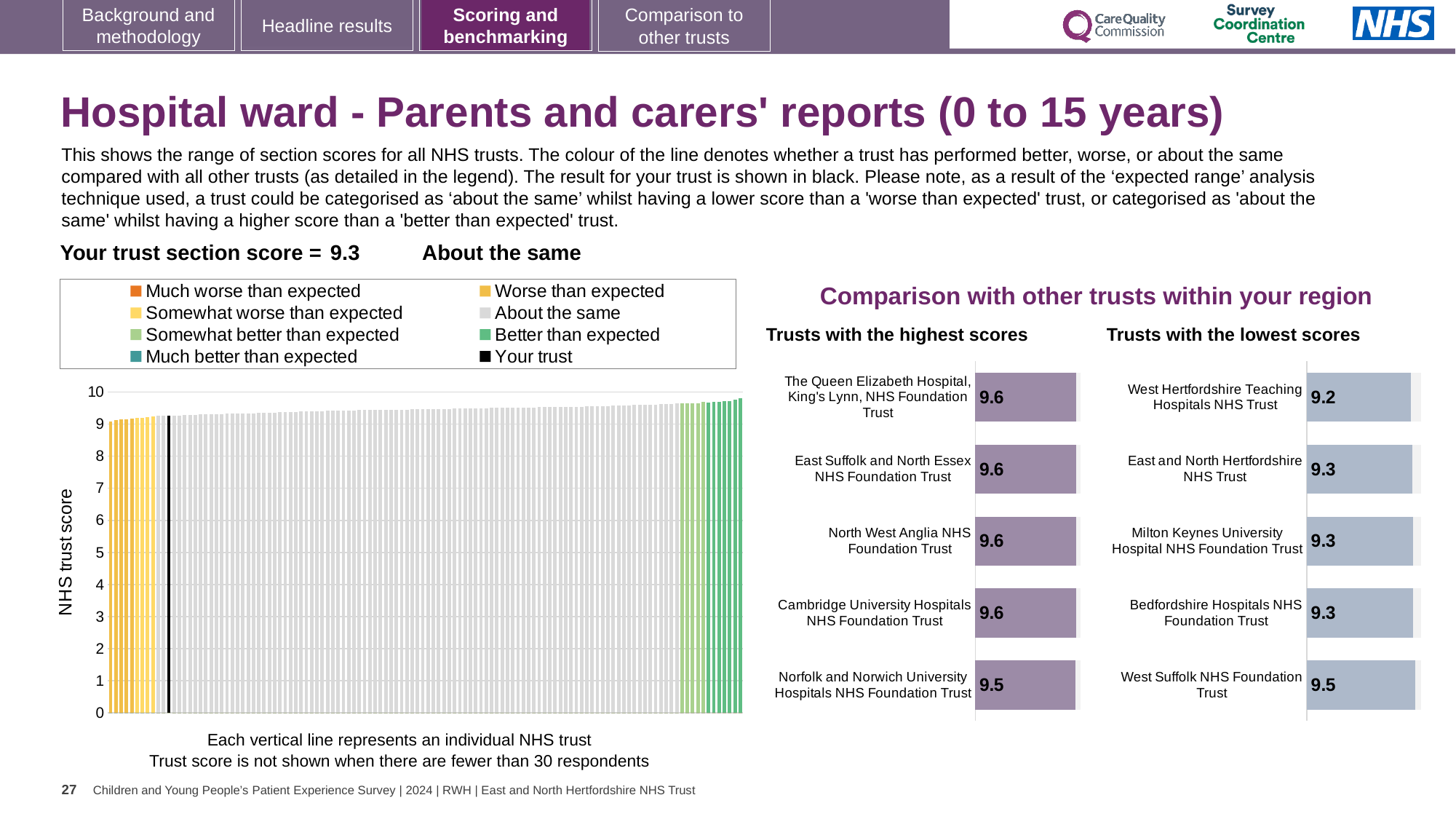
In the large chart on the left, what is the section score for your trust (shown in black)? 9.3 In the 'Trusts with the lowest scores' chart, which trust has the highest score? West Suffolk NHS Foundation Trust In the 'Trusts with the highest scores' chart, what is the difference between the score for The Queen Elizabeth Hospital, King's Lynn, NHS Foundation Trust and the score for Norfolk and Norwich University Hospitals NHS Foundation Trust? 0.1 How many trusts are listed in the 'Trusts with the highest scores' chart? 5 In the large chart on the left, do the trust scores rise or fall from left to right along the x axis? rise What kind of chart is the large chart on the left showing the range of section scores for all NHS trusts? bar chart In the 'Trusts with the lowest scores' chart, which has the larger score: East and North Hertfordshire NHS Trust or West Suffolk NHS Foundation Trust? West Suffolk NHS Foundation Trust In the 'Trusts with the lowest scores' chart, which trust has the lowest score? West Hertfordshire Teaching Hospitals NHS Trust In the 'Trusts with the lowest scores' chart, what is the score for West Hertfordshire Teaching Hospitals NHS Trust? 9.2 In the 'Trusts with the lowest scores' chart, what is the difference between the score for West Suffolk NHS Foundation Trust and the score for West Hertfordshire Teaching Hospitals NHS Trust? 0.3 How many entries does the legend of the large chart on the left list? 8 In the 'Trusts with the highest scores' chart, what is the score for Norfolk and Norwich University Hospitals NHS Foundation Trust? 9.5